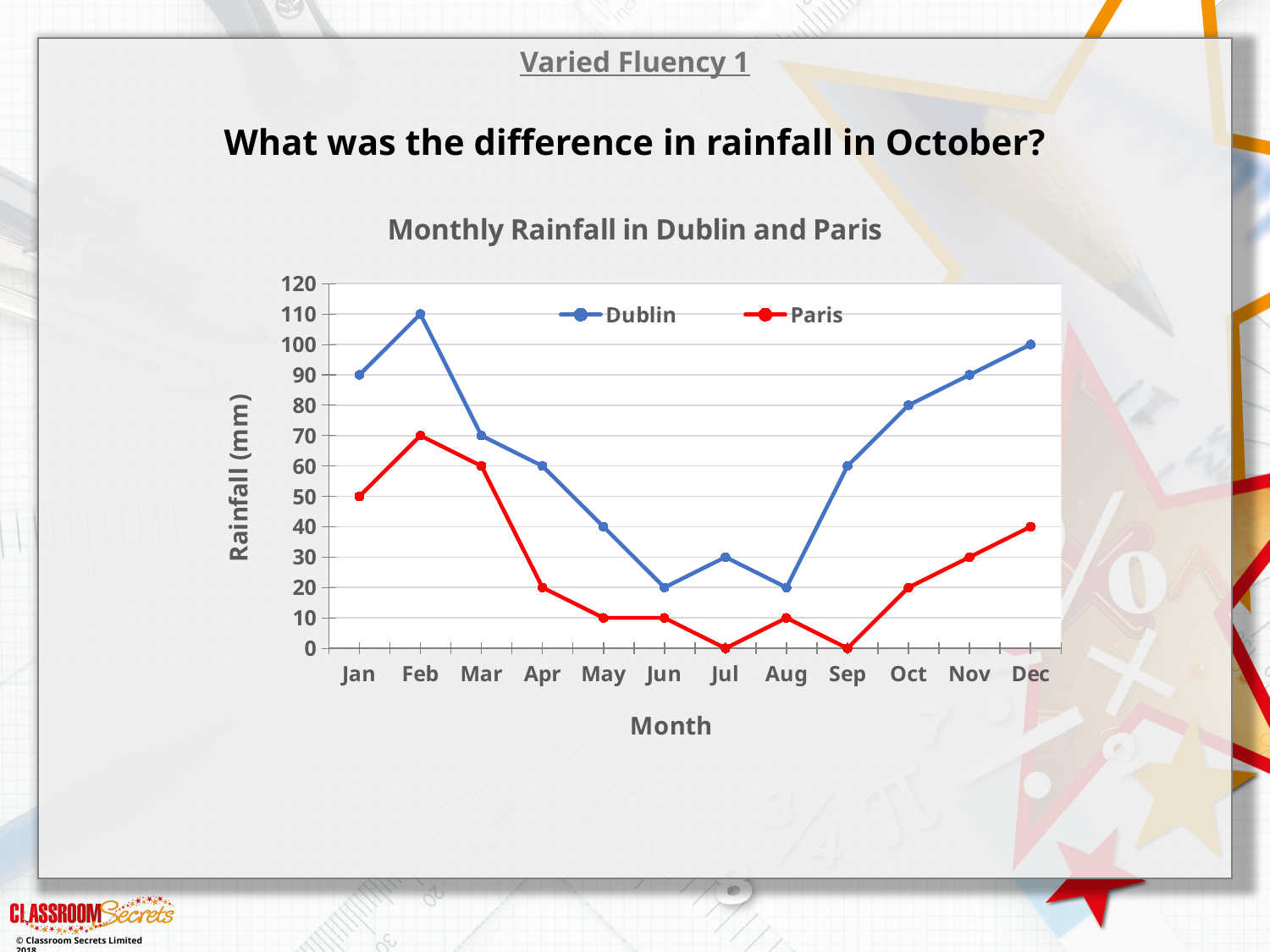
Does Dublin's rainfall rise or fall from September to December? rise How many series does the legend list? 2 What is the rainfall for Dublin in October? 80 What is the rainfall for Dublin in December? 100 Which has higher rainfall in March, Dublin or Paris? Dublin What is the title of the chart? Monthly Rainfall in Dublin and Paris How many months are plotted on the x axis? 12 What is the difference in rainfall between Dublin and Paris in October? 60 In which month is Dublin's rainfall highest? Feb What type of chart is shown on the slide? line chart What is the rainfall for Paris in October? 20 What is the rainfall for Paris in February? 70